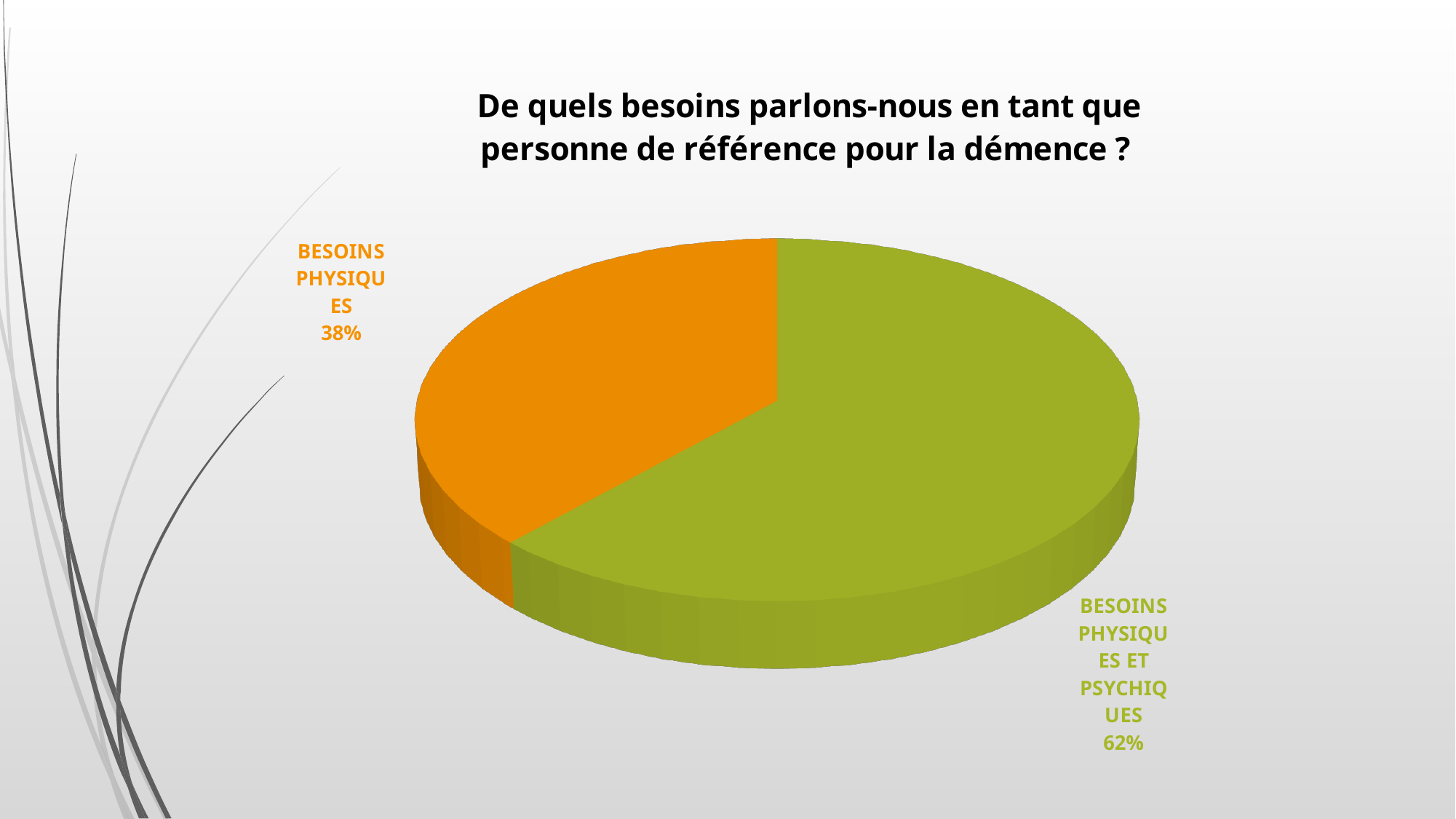
Is the share for BESOINS PHYSIQUES greater or less than 50%? less How many slices does the pie chart have? 2 What is the title of the chart? De quels besoins parlons-nous en tant que personne de référence pour la démence ? What colour is the BESOINS PHYSIQUES slice? Orange Which is larger: the BESOINS PHYSIQUES slice or the BESOINS PHYSIQUES ET PSYCHIQUES slice? BESOINS PHYSIQUES ET PSYCHIQUES What share of the pie is labelled BESOINS PHYSIQUES ET PSYCHIQUES? 62% Which slice is the smallest? BESOINS PHYSIQUES What share of the pie is labelled BESOINS PHYSIQUES? 38% What is the difference in percentage points between the BESOINS PHYSIQUES ET PSYCHIQUES slice and the BESOINS PHYSIQUES slice? 24 percentage points What kind of chart is shown on the slide? Pie chart Which slice is the largest? BESOINS PHYSIQUES ET PSYCHIQUES